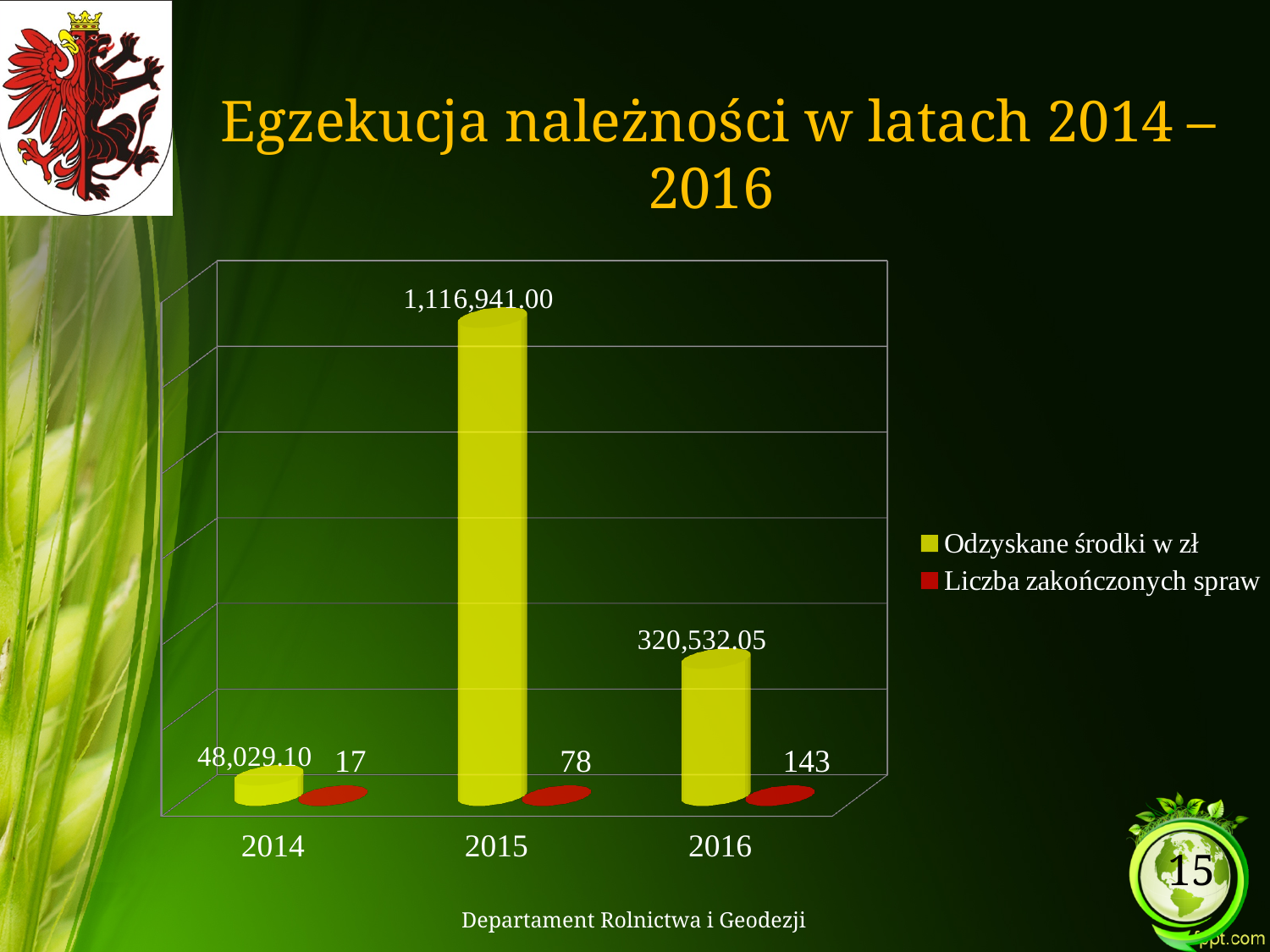
How many years are shown on the x axis of the chart? 3 What value is shown for Odzyskane środki w zł in 2015? 1,116,941.00 What value is shown for Odzyskane środki w zł in 2016? 320,532.05 What is the Liczba zakończonych spraw value for 2014? 17 What is the Liczba zakończonych spraw value for 2016? 143 Which year has the lowest value for Liczba zakończonych spraw? 2014 Which year has the highest value for Odzyskane środki w zł? 2015 What value is shown for Odzyskane środki w zł in 2014? 48,029.10 Which is larger: Odzyskane środki w zł in 2016 or in 2014? 2016 Does the Liczba zakończonych spraw series rise or fall from 2014 to 2016? rise What is the difference between the Liczba zakończonych spraw values for 2016 and 2015? 65 How many series does the chart legend list? 2